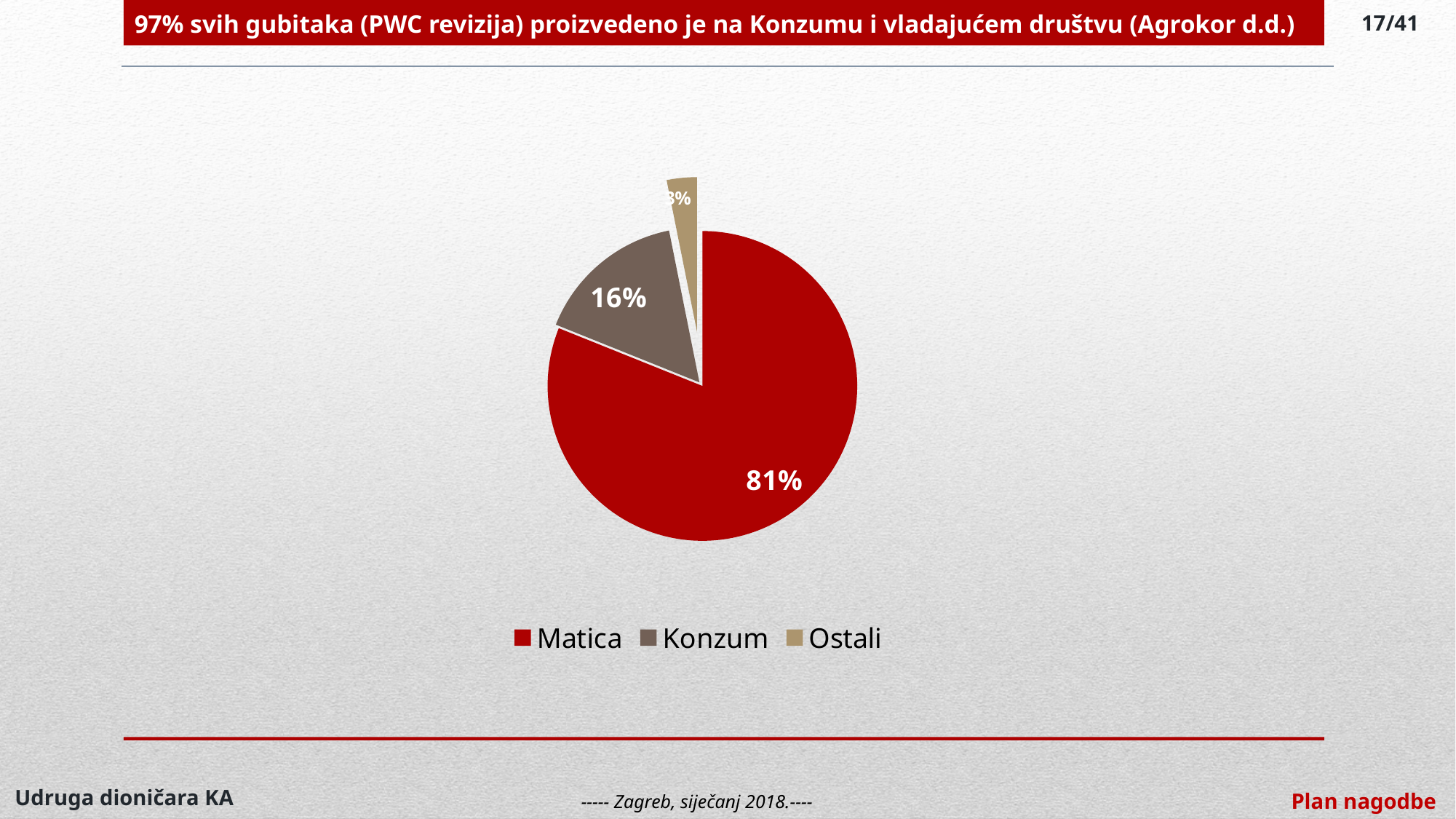
Which slice is larger, Konzum or Ostali? Konzum Which category has the largest slice of the pie? Matica Which legend entry is shown in grey-brown? Konzum Which category has the smallest slice of the pie? Ostali What share of the pie does Konzum hold? 16% By how many percentage points does Matica's share exceed Konzum's share? 65 percentage points What colour is the Matica slice in the pie chart? red What type of chart is shown on the slide? pie chart How many categories does the pie chart show? 3 What is the combined share of Matica and Konzum? 97% What share of the pie does Matica hold? 81% How many entries does the legend list? 3